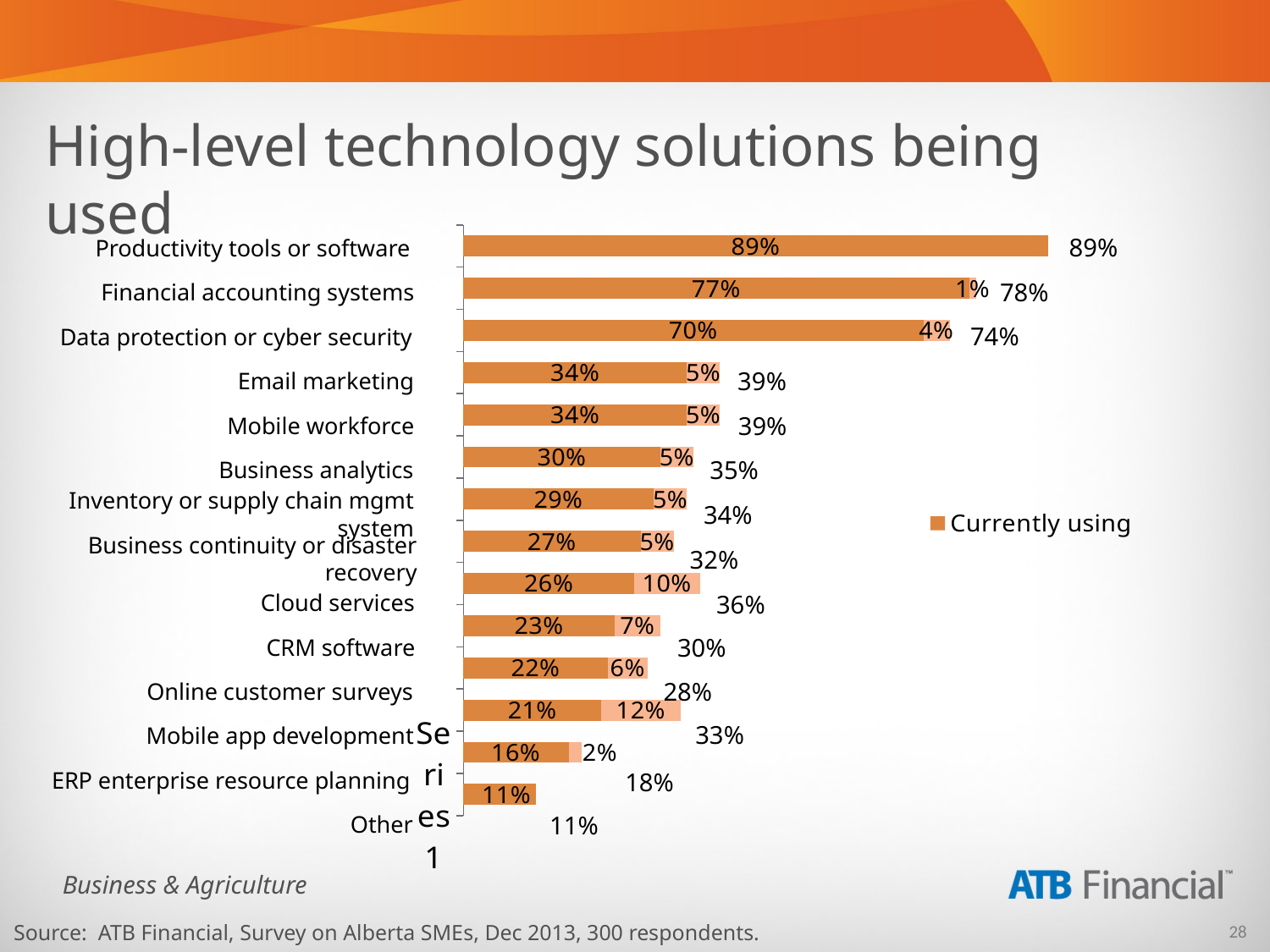
What kind of chart is shown on the slide? Bar chart Which category has the highest 'Currently using' value? Productivity tools or software Which category has the lowest 'Currently using' value? Other What is the 'Currently using' value for Data protection or cyber security? 70% What is the total shown for the Mobile app development bar? 33% What is the total shown for the ERP enterprise resource planning bar? 18% What is the 'Currently using' value for Cloud services? 26% How many series does the legend list? 1 What is the 'Currently using' value for Productivity tools or software? 89% Which has a larger 'Currently using' value, CRM software or Mobile app development? CRM software What is the difference between the 'Currently using' values for Financial accounting systems and Data protection or cyber security? 7% How many categories are shown on the chart? 14